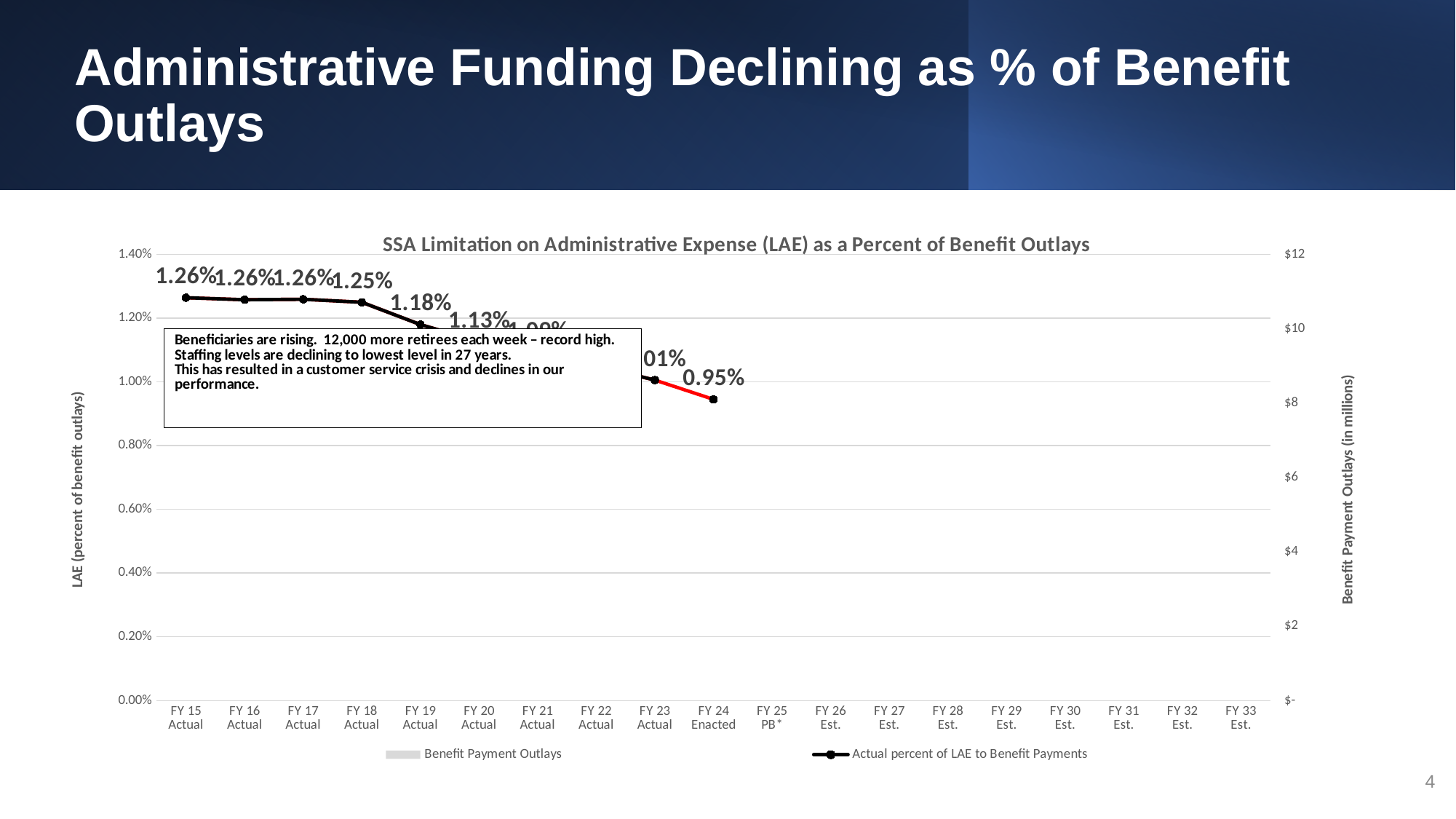
How many fiscal year categories are shown on the x axis? 19 What is the value for FY 20 Actual on the line for Actual percent of LAE to Benefit Payments? 1.13% What is the value for FY 19 Actual on the line for Actual percent of LAE to Benefit Payments? 1.18% What is the title of the chart? SSA Limitation on Administrative Expense (LAE) as a Percent of Benefit Outlays How many series does the legend list? 2 Which plotted fiscal year has the lowest Actual percent of LAE to Benefit Payments? FY 24 Enacted What is the value for FY 24 Enacted on the line for Actual percent of LAE to Benefit Payments? 0.95% Which is larger, the value for FY 18 Actual or the value for FY 19 Actual? FY 18 Actual What is the difference between the FY 15 Actual value (1.26%) and the FY 24 Enacted value (0.95%)? 0.31% Does the Actual percent of LAE to Benefit Payments rise or fall from FY 15 to FY 24? fall Is the value for FY 24 Enacted greater or less than 1.00%? less What is the value for FY 15 Actual on the line for Actual percent of LAE to Benefit Payments? 1.26%